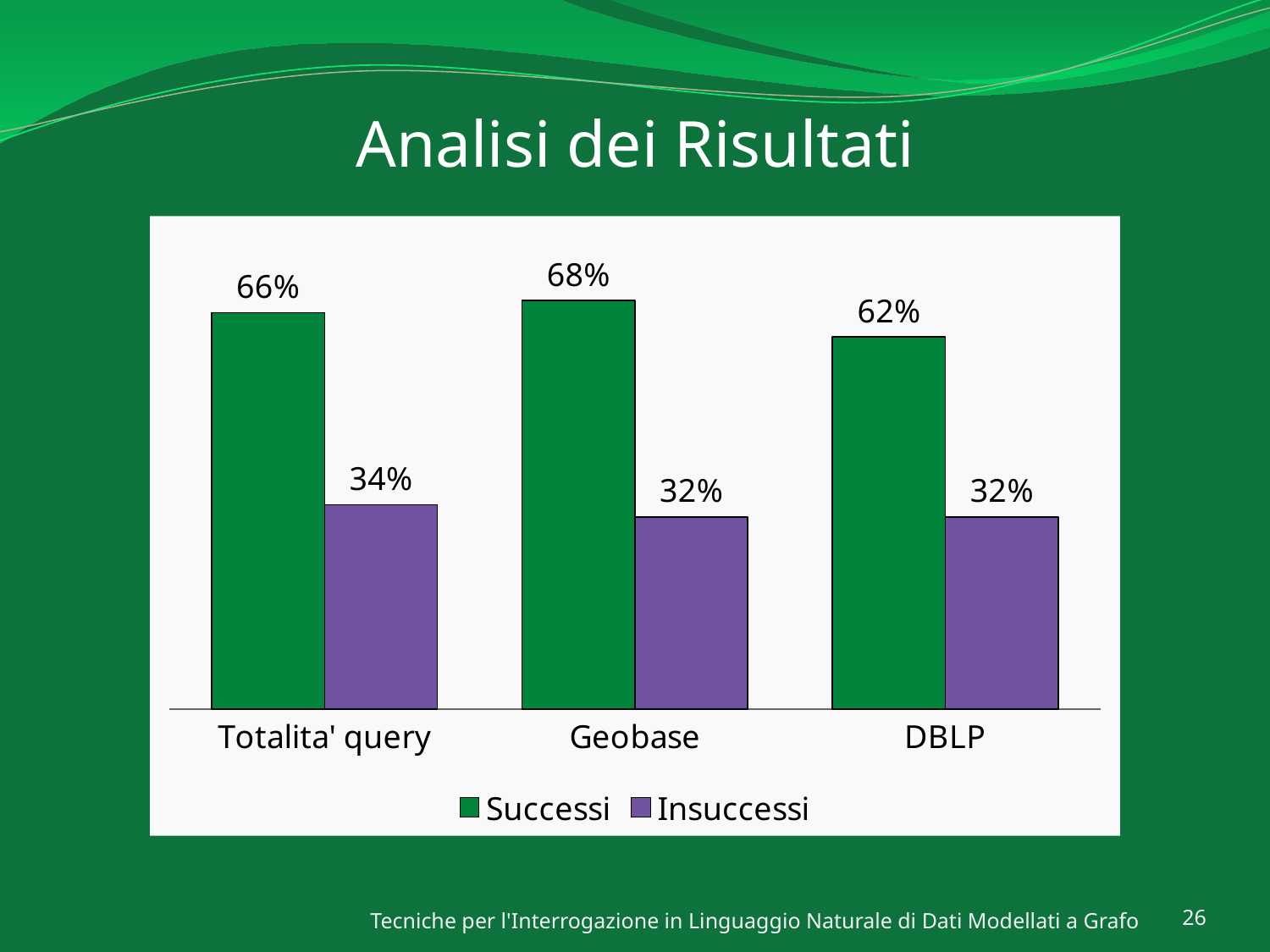
What is the Insuccessi value for Totalita' query? 34% What is the Successi value for DBLP? 62% What is the title of the slide containing the chart? Analisi dei Risultati Which is larger, the Insuccessi value for Totalita' query or the Insuccessi value for Geobase? Totalita' query Which category has the lowest Successi value? DBLP What is the Successi value for Geobase? 68% How many categories are shown on the x axis? 3 What is the difference between the Successi values for Geobase and DBLP? 6% How many series does the legend list? 2 Which category has the highest Successi value? Geobase What is the difference between the Successi and Insuccessi values for DBLP? 30% What kind of chart is shown on the slide? Bar chart